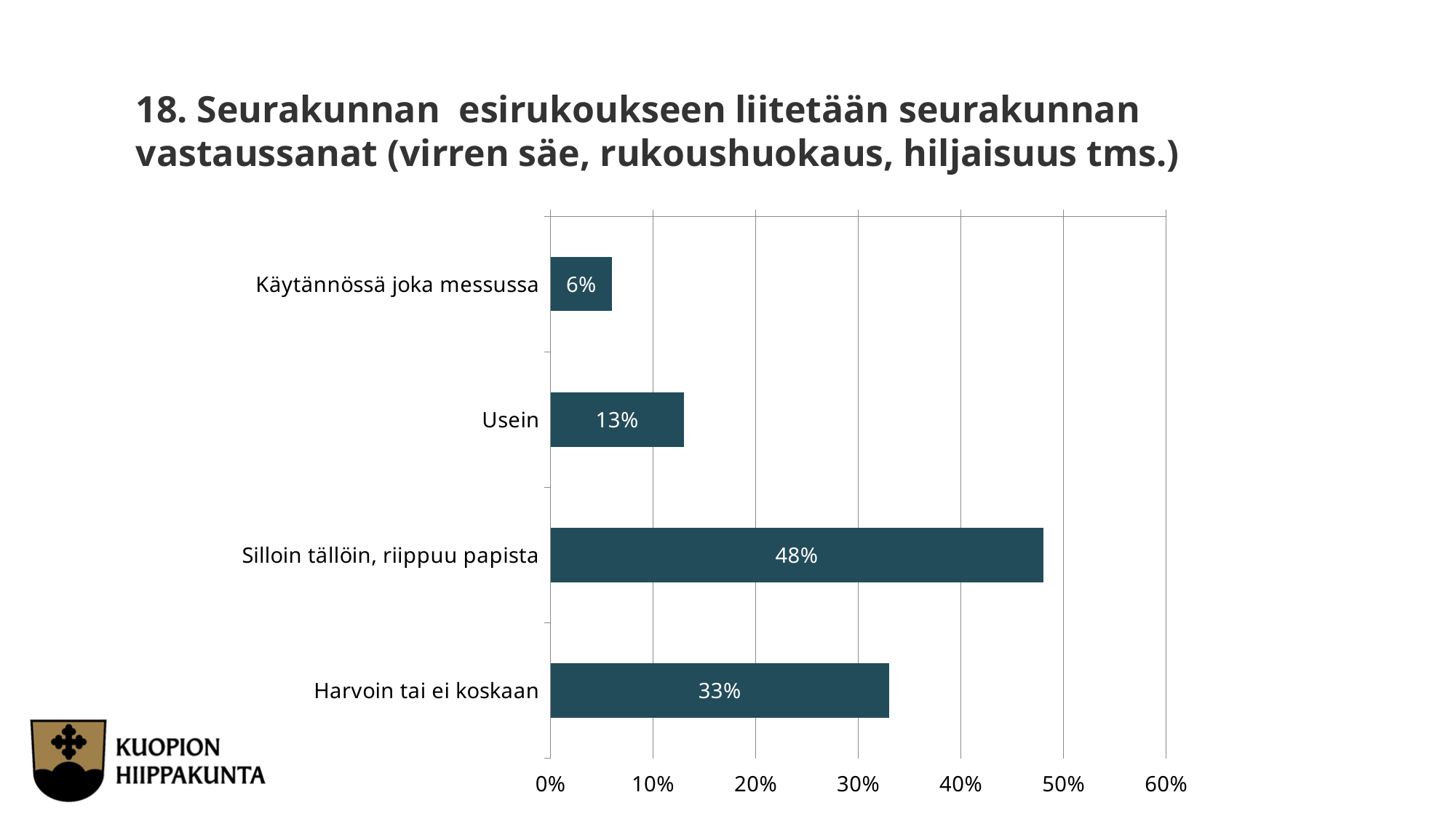
What is the value for "Käytännössä joka messussa"? 6% What kind of chart is shown on the slide? bar chart Which is larger, the value for "Usein" or the value for "Harvoin tai ei koskaan"? Harvoin tai ei koskaan What is the value for "Usein"? 13% What is the difference between the values for "Silloin tällöin, riippuu papista" and "Harvoin tai ei koskaan"? 15% How many categories are shown in the chart? 4 What is the value for "Harvoin tai ei koskaan"? 33% What is the highest value shown on the horizontal axis? 60% What is the value for "Silloin tällöin, riippuu papista"? 48% Which category has the lowest value? Käytännössä joka messussa Which category has the highest value? Silloin tällöin, riippuu papista Is the value for "Silloin tällöin, riippuu papista" greater or less than 40%? greater